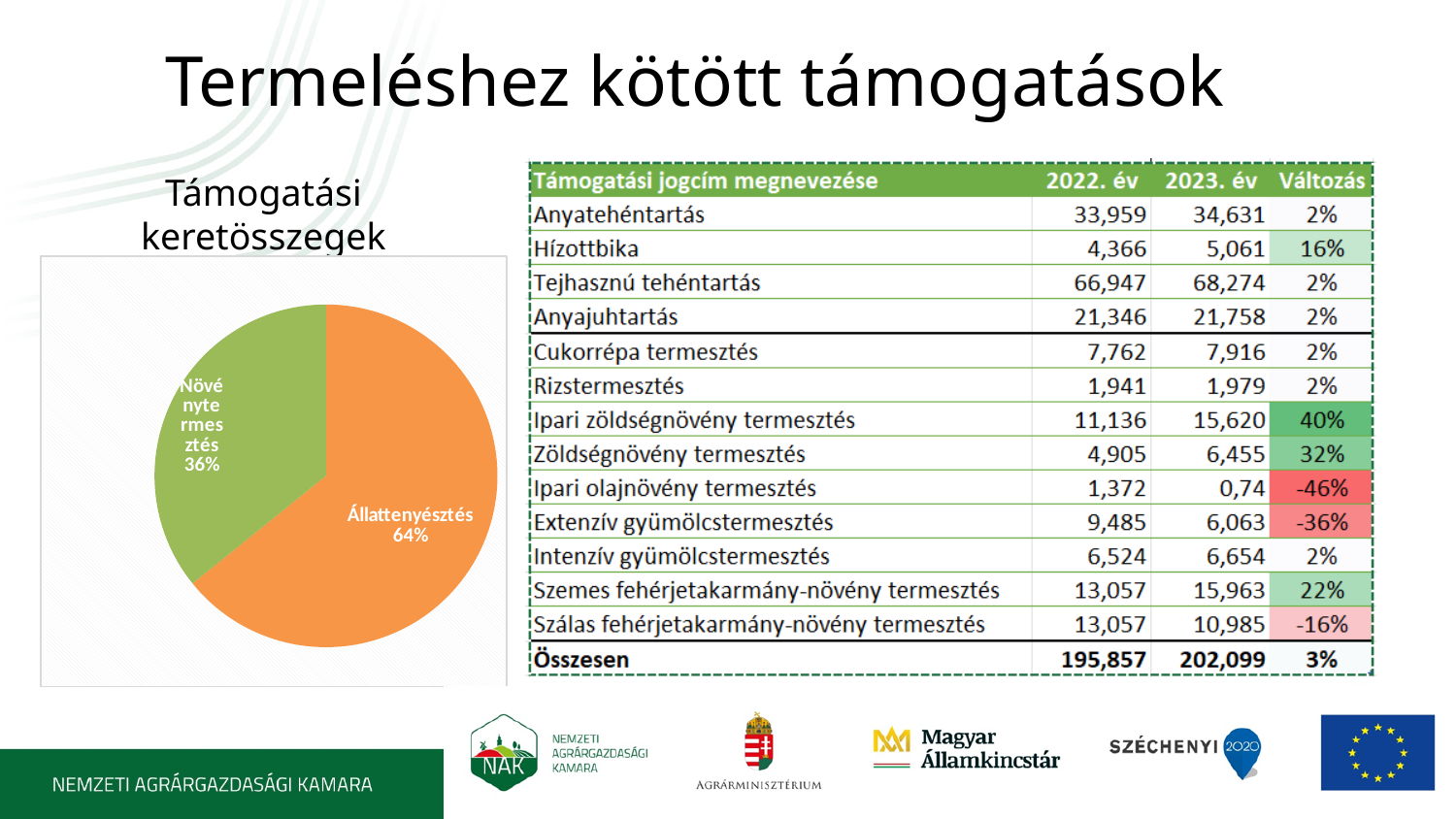
In the pie chart, which is larger: Állattenyésztés or Növénytermesztés? Állattenyésztés What kind of chart is shown under the heading "Támogatási keretösszegek"? pie chart Which slice of the pie chart is the largest? Állattenyésztés What is the title of the pie chart? Támogatási keretösszegek What colour is the Állattenyésztés slice in the pie chart? orange In the pie chart, what share does Állattenyésztés have? 64% In the pie chart, by how many percentage points does Állattenyésztés exceed Növénytermesztés? 28 How many slices does the pie chart have? 2 Which slice of the pie chart is the smallest? Növénytermesztés In the pie chart, what share does Növénytermesztés have? 36%